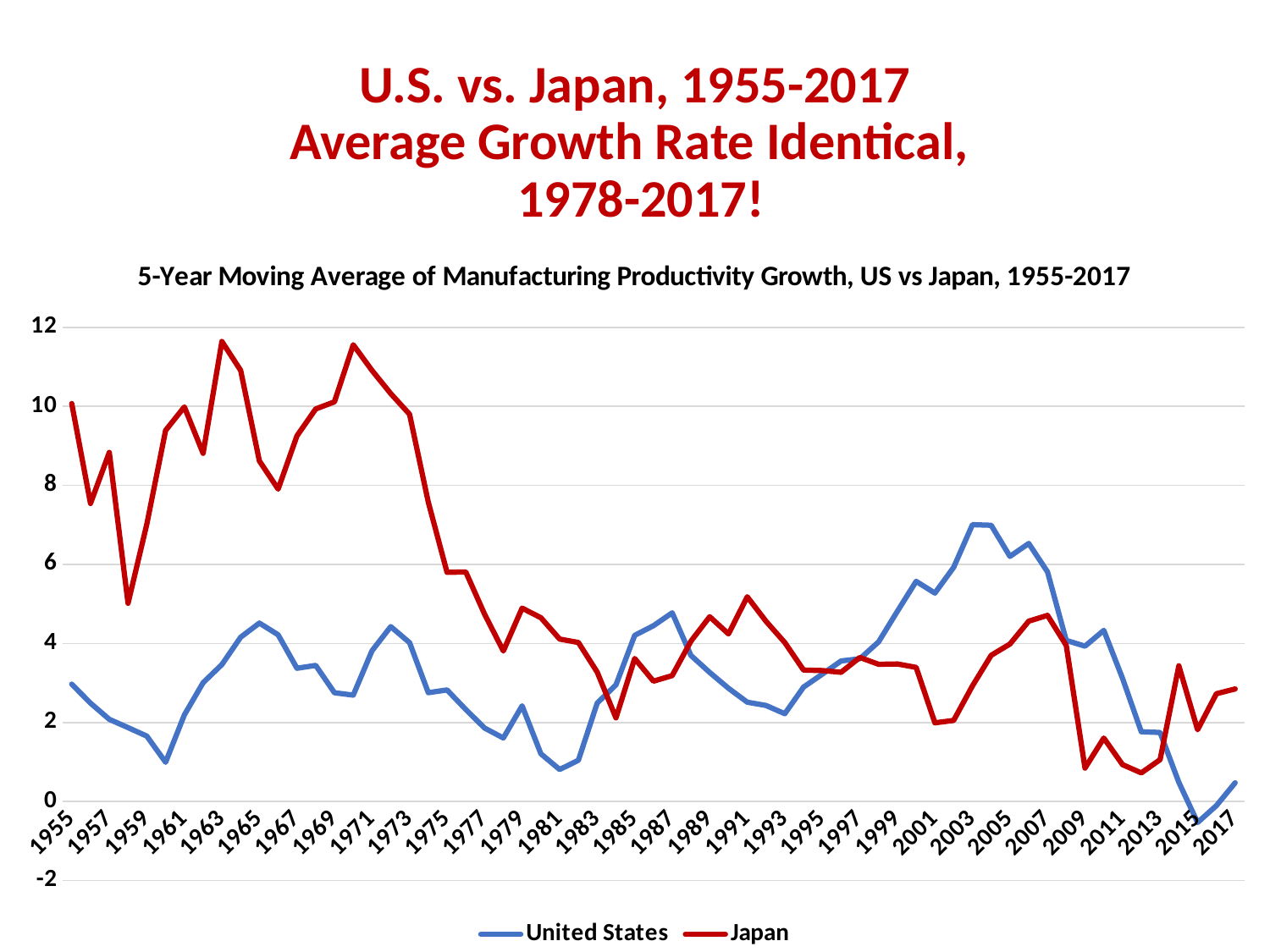
Is the value for the United States in 1981 greater or less than 2? less Which colour is used for the Japan line? red Is the value for the United States in 2015 greater or less than 0? less What is the title of the chart? 5-Year Moving Average of Manufacturing Productivity Growth, US vs Japan, 1955-2017 What kind of chart is shown on the slide? line chart Does the United States line rise or fall between 2007 and 2015? fall Is the value for Japan in 1963 greater or less than 10? greater In 1963, which series has the higher value, United States or Japan? Japan In 2003, which series has the higher value, United States or Japan? United States How many series does the legend list? 2